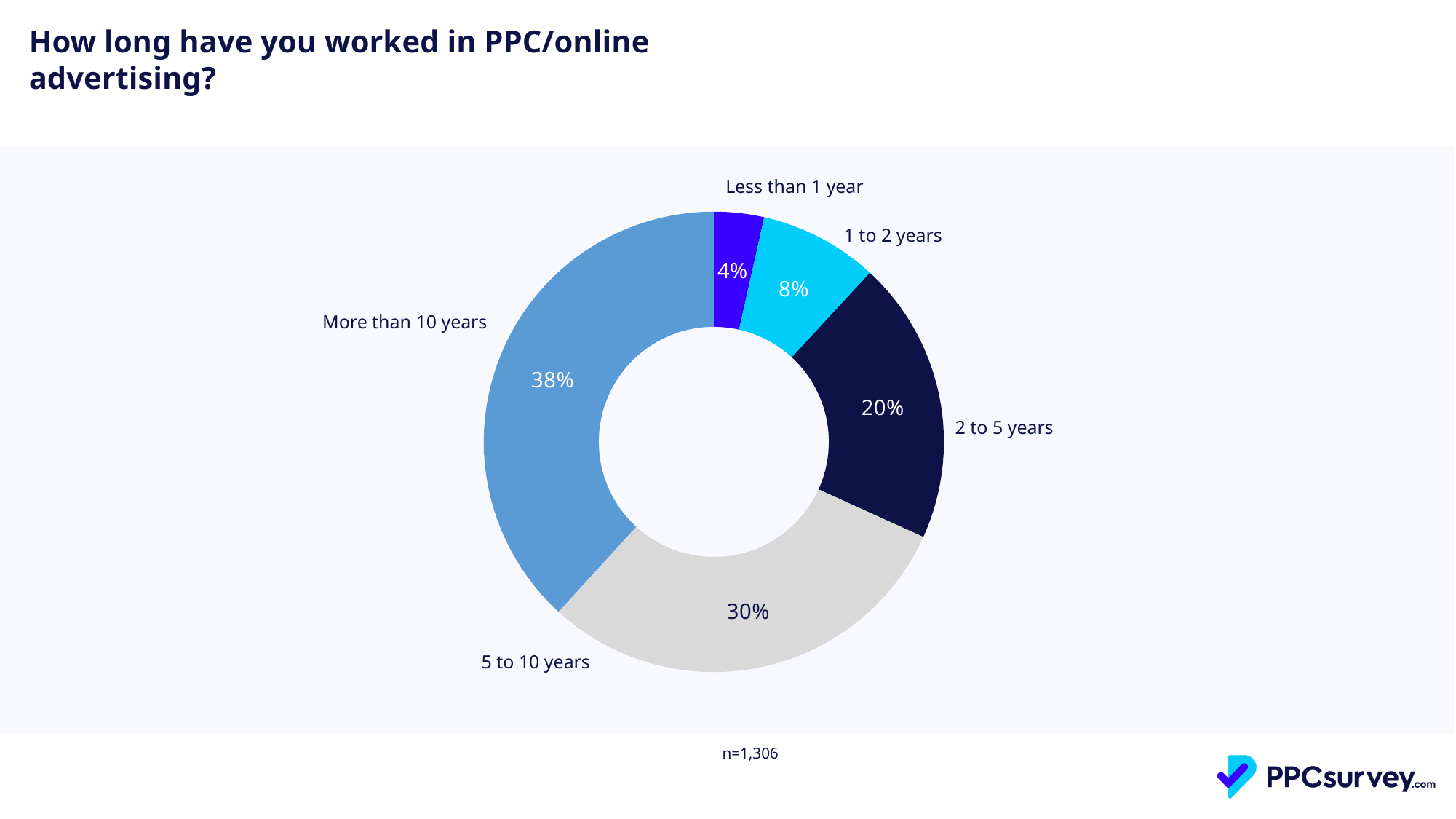
What is the sample size (n) shown below the chart? n=1,306 What percentage of respondents have 5 to 10 years of experience? 30% What is the combined share of respondents with 5 or more years of experience? 68% What type of chart is shown on the slide? Pie chart (donut) How many experience categories are shown in the chart? 5 What share of respondents have 2 to 5 years of experience? 20% What is the difference in percentage points between the 'More than 10 years' and '5 to 10 years' categories? 8 What percentage of respondents have worked in PPC/online advertising for more than 10 years? 38% What percentage of respondents have less than 1 year of experience? 4% Which experience category has the smallest share of respondents? Less than 1 year Which experience category has the largest share of respondents? More than 10 years Which is larger: the share for '1 to 2 years' or the share for '2 to 5 years'? 2 to 5 years